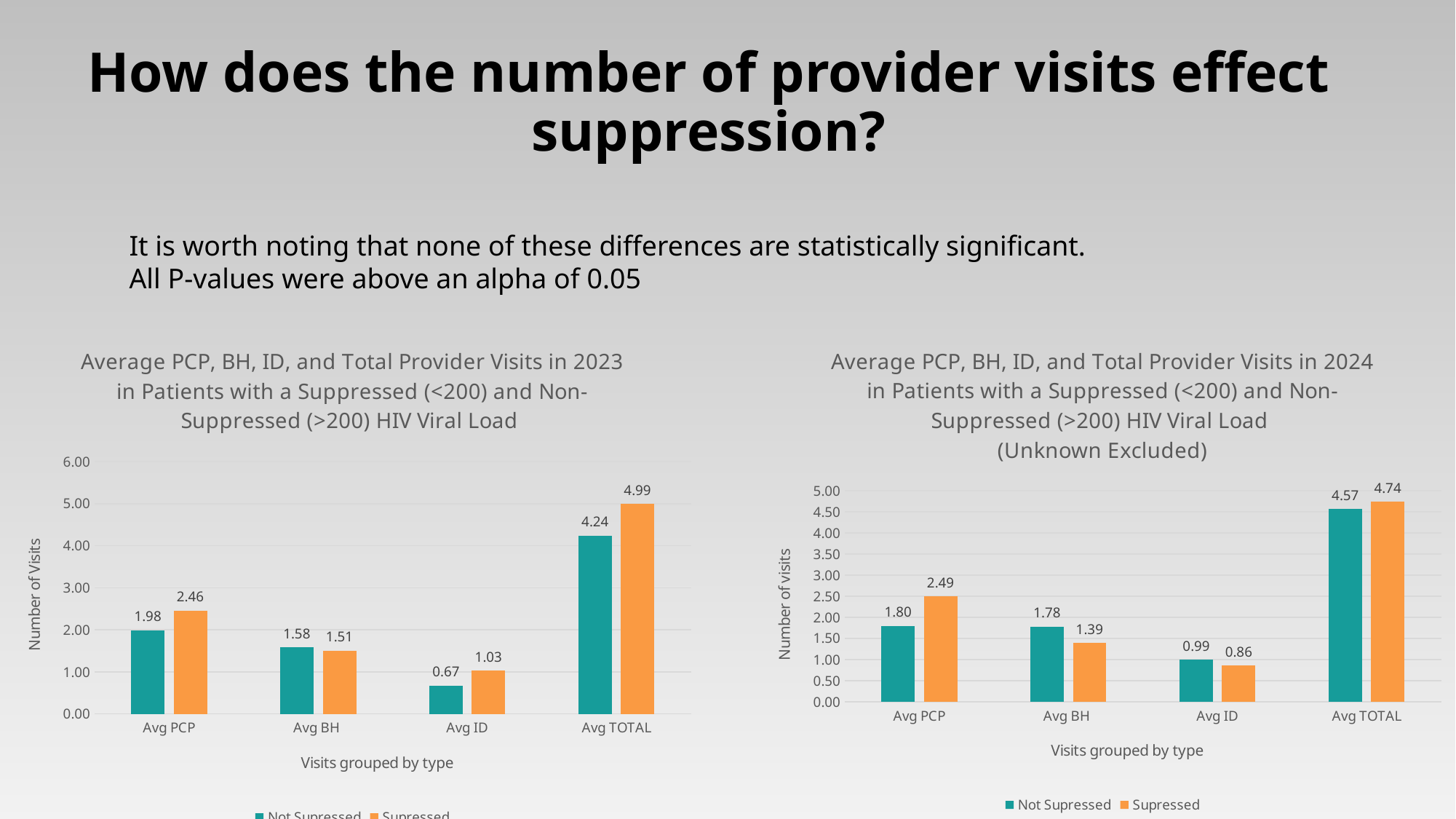
In the 2023 chart (left), what is the value for Supressed at Avg TOTAL? 4.99 In the 2023 chart (left), is the Not Supressed value for Avg TOTAL greater or less than 4.00? greater How many categories are shown on the x axis of the 2024 chart (right)? 4 What kind of chart is the 2023 chart (left)? Bar chart In the 2024 chart (right), which category has the highest Supressed value? Avg TOTAL In the 2023 chart (left), what is the value for Not Supressed at Avg PCP? 1.98 In the 2023 chart (left), which category has the lowest Not Supressed value? Avg ID In the 2023 chart (left), what is the difference between the Supressed and Not Supressed values at Avg PCP? 0.48 In the 2024 chart (right), what is the value for Not Supressed at Avg ID? 0.99 In the 2024 chart (right), what is the value for Supressed at Avg PCP? 2.49 In the 2024 chart (right), what is the difference between the Supressed and Not Supressed values at Avg TOTAL? 0.17 In the 2024 chart (right), which is larger at Avg BH: Not Supressed or Supressed? Not Supressed